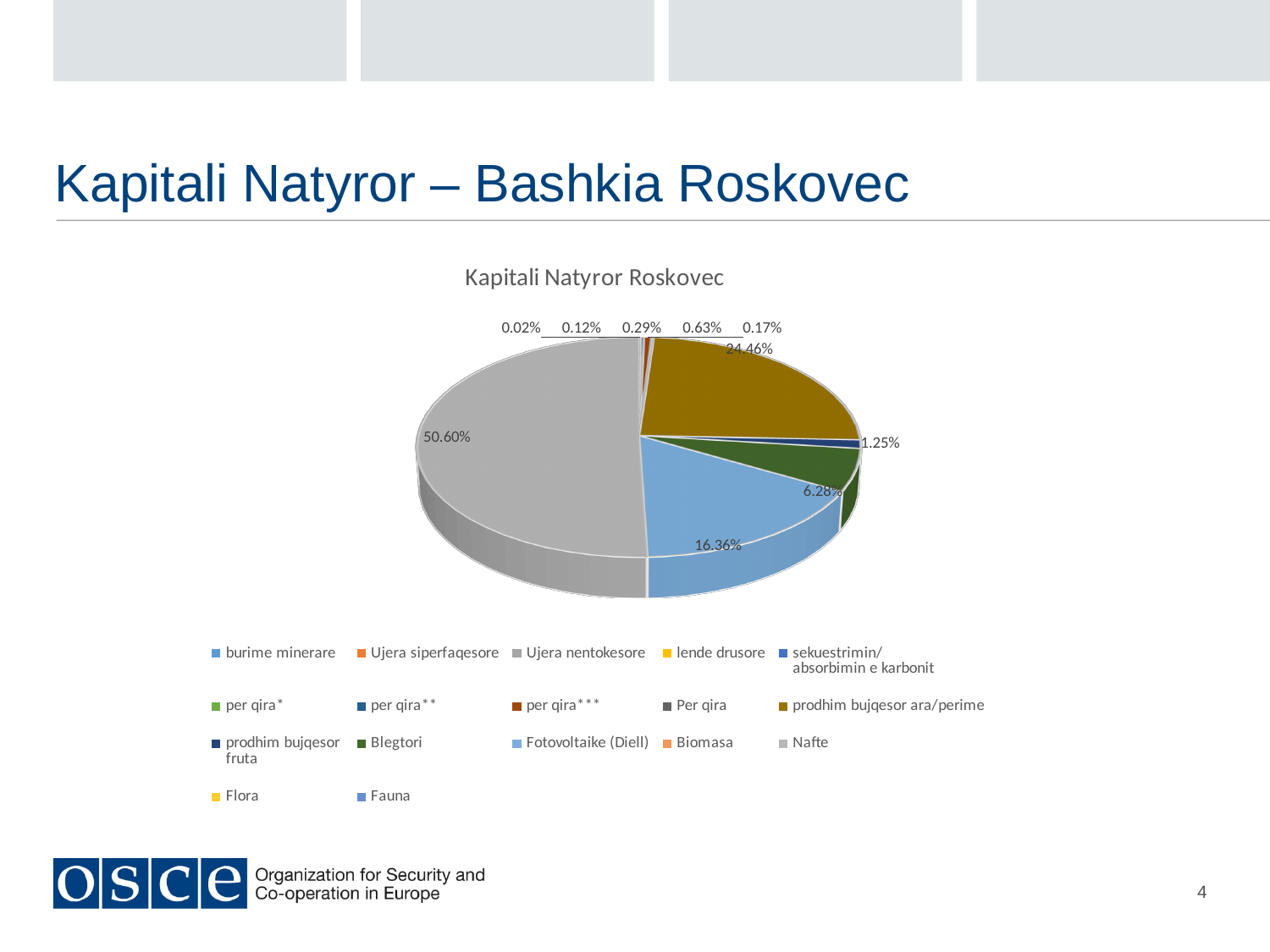
What is the share of the largest slice in the pie chart? 50.60% What is the share of the dark green slice (Blegtori)? 6.28% What type of chart is shown on the slide? pie chart What is the combined share of the two largest slices (50.60% and 24.46%)? 75.06% How many entries does the chart legend list? 17 What is the share of the dark gold slice (prodhim bujqesor ara/perime)? 24.46% What is the smallest labelled share in the pie chart? 0.02% What is the difference between the largest slice (50.60%) and the second largest slice (24.46%)? 26.14% Is the share of the largest slice greater or less than 50%? greater What is the title of the chart? Kapitali Natyror Roskovec What is the difference between the 16.36% slice and the 6.28% slice? 10.08% Which is larger, the slice labelled 16.36% or the slice labelled 24.46%? 24.46%